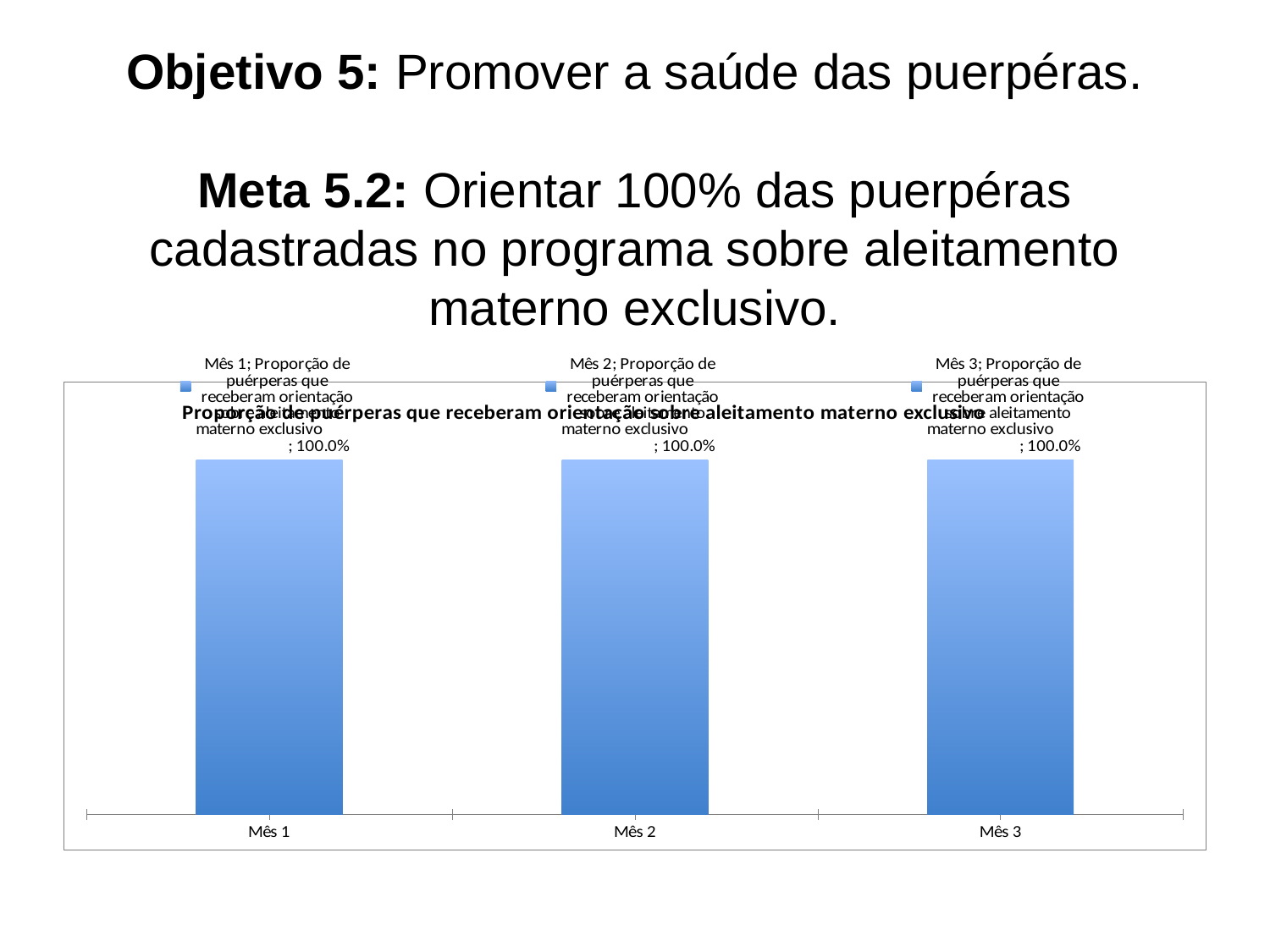
What is the value for Mês 2? 100.0% What is the label of the last category on the x axis? Mês 3 What colour are the bars in the chart? Blue What is the title of the chart? Proporção de puérperas que receberam orientação sobre aleitamento materno exclusivo What is the label of the first category on the x axis? Mês 1 Do the values rise, fall or stay the same from Mês 1 to Mês 3? Stay the same What kind of chart is shown on the slide? Bar chart How many categories are shown on the x axis of the chart? 3 What is the value for Mês 3? 100.0% What is the value for Mês 1? 100.0% What is the difference between the values for Mês 1 and Mês 3? 0.0%